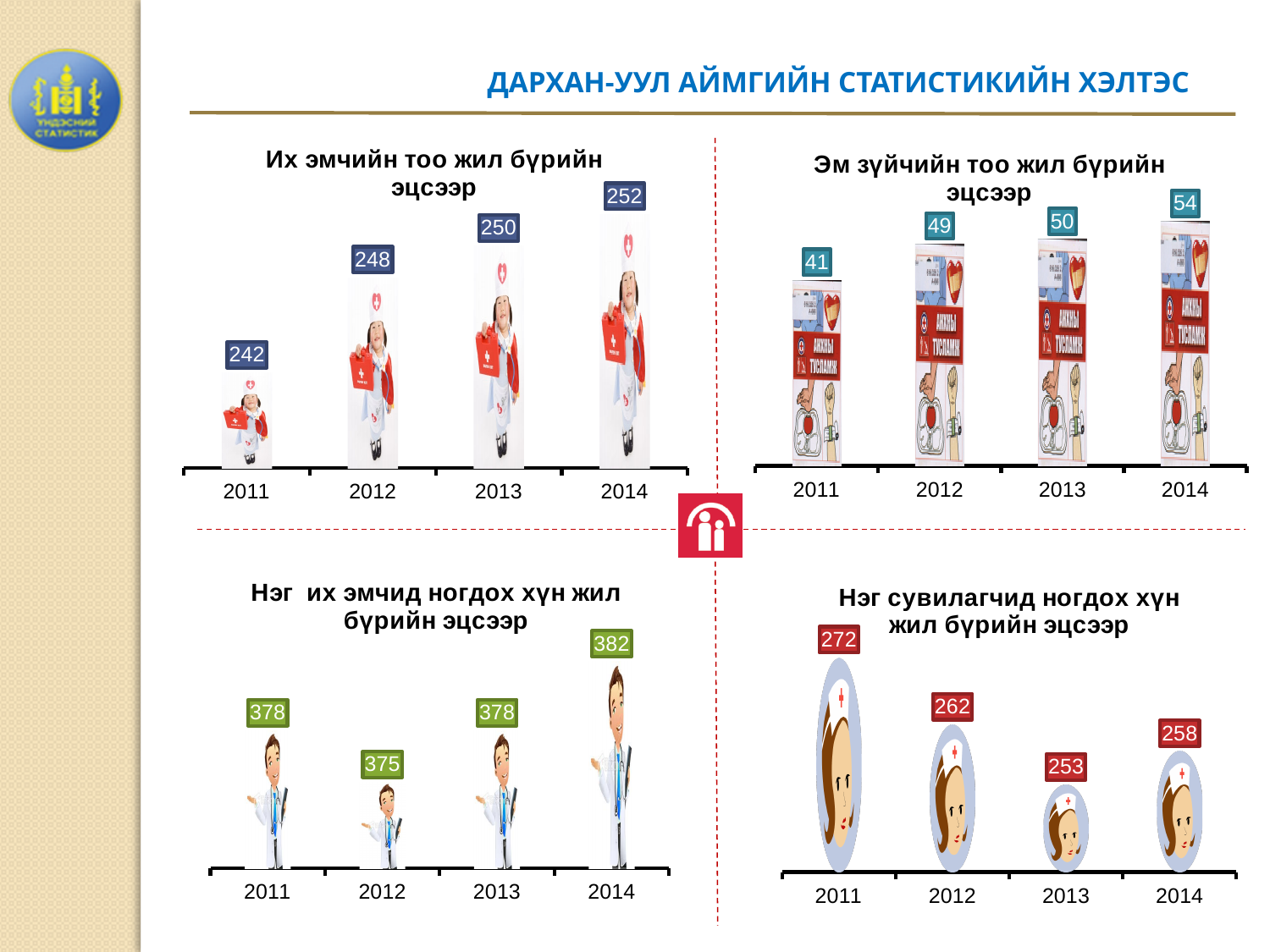
In the top-left chart (Их эмчийн тоо жил бүрийн эцсээр), what is the difference between the 2014 and 2011 values? 10 In the bottom-right chart (Нэг сувилагчид ногдох хүн жил бүрийн эцсээр), which is larger, the value for 2011 or the value for 2014? 2011 In the bottom-left chart (Нэг их эмчид ногдох хүн жил бүрийн эцсээр), which year has the highest value? 2014 How many years are shown on the x axis of the bottom-right chart (Нэг сувилагчид ногдох хүн жил бүрийн эцсээр)? 4 In the top-left chart (Их эмчийн тоо жил бүрийн эцсээр), do the values rise or fall from 2011 to 2014? rise In the top-right chart (Эм зүйчийн тоо жил бүрийн эцсээр), what is the value for 2012? 49 In the top-left chart (Их эмчийн тоо жил бүрийн эцсээр), what is the value for 2011? 242 In the top-right chart (Эм зүйчийн тоо жил бүрийн эцсээр), which year has the lowest value? 2011 In the top-left chart (Их эмчийн тоо жил бүрийн эцсээр), which year has the highest value? 2014 In the top-right chart (Эм зүйчийн тоо жил бүрийн эцсээр), what is the difference between the 2014 and 2013 values? 4 In the bottom-right chart (Нэг сувилагчид ногдох хүн жил бүрийн эцсээр), what is the value for 2013? 253 In the bottom-left chart (Нэг их эмчид ногдох хүн жил бүрийн эцсээр), what is the value for 2012? 375